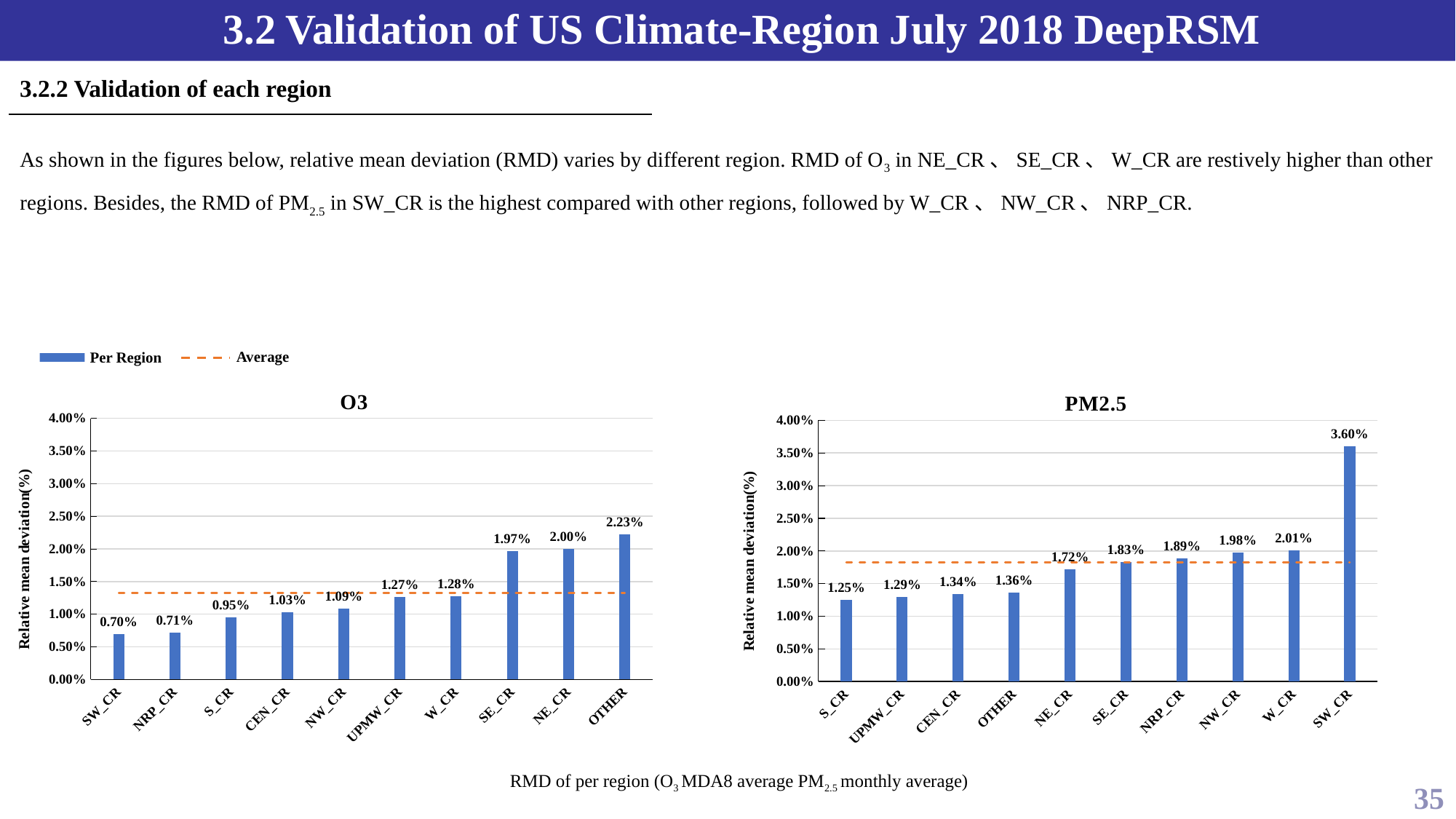
In the O3 chart, which is larger, the value for NE_CR or the value for CEN_CR? NE_CR How many regions are shown on the x axis of the O3 chart? 10 In the PM2.5 chart, what is the relative mean deviation for NRP_CR? 1.89% In the PM2.5 chart, is the value for SW_CR greater or less than 3.00%? greater In the O3 chart, what is the relative mean deviation for SE_CR? 1.97% In the PM2.5 chart, what is the difference between the values for SW_CR and W_CR? 1.59% In the O3 chart, which region has the lowest relative mean deviation? SW_CR What kind of chart is the PM2.5 chart? bar chart How many series does the legend list? 2 In the O3 chart, do the bar values rise or fall from left to right along the x axis? rise In the O3 chart, what is the difference between the values for OTHER and SW_CR? 1.53% In the PM2.5 chart, which region has the highest relative mean deviation? SW_CR